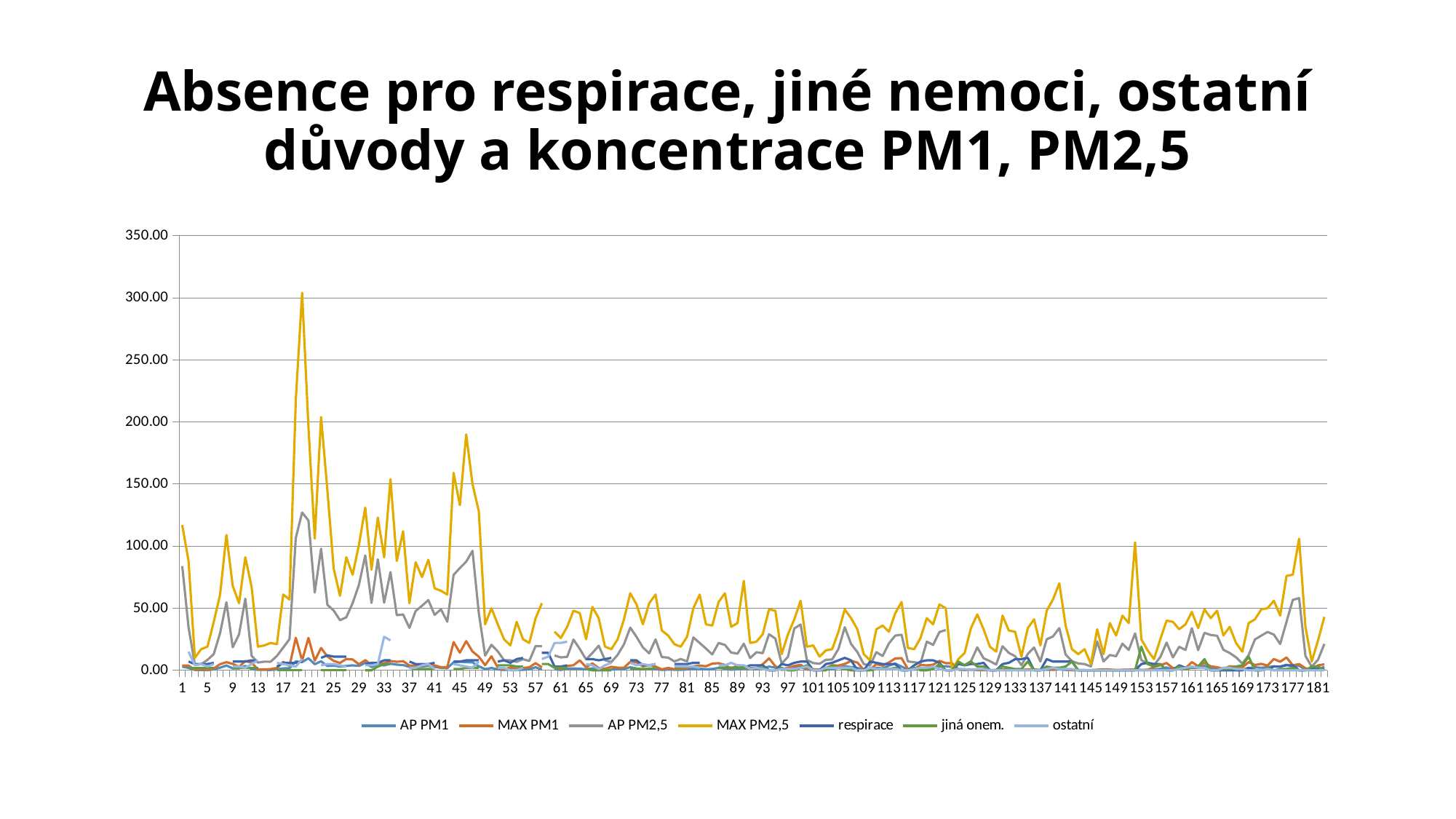
What is the last label shown on the x axis? 181 Is the value of MAX PM2,5 at point 1 greater or less than 100? greater What is the title of the chart? Absence pro respirace, jiné nemoci, ostatní důvody a koncentrace PM1, PM2,5 Which series reaches the highest value anywhere on the chart? MAX PM2,5 How many series does the legend list? 7 Which series is larger around point 21: MAX PM2,5 or AP PM1? MAX PM2,5 Is the highest peak of the MAX PM2,5 series greater or less than 250? greater What colour is the MAX PM2,5 line? yellow What kind of chart is shown on the slide? line chart Is the highest peak of the AP PM2,5 series greater or less than 100? greater Do the values of the MAX PM2,5 series generally rise or fall from the left of the x axis to the right? fall